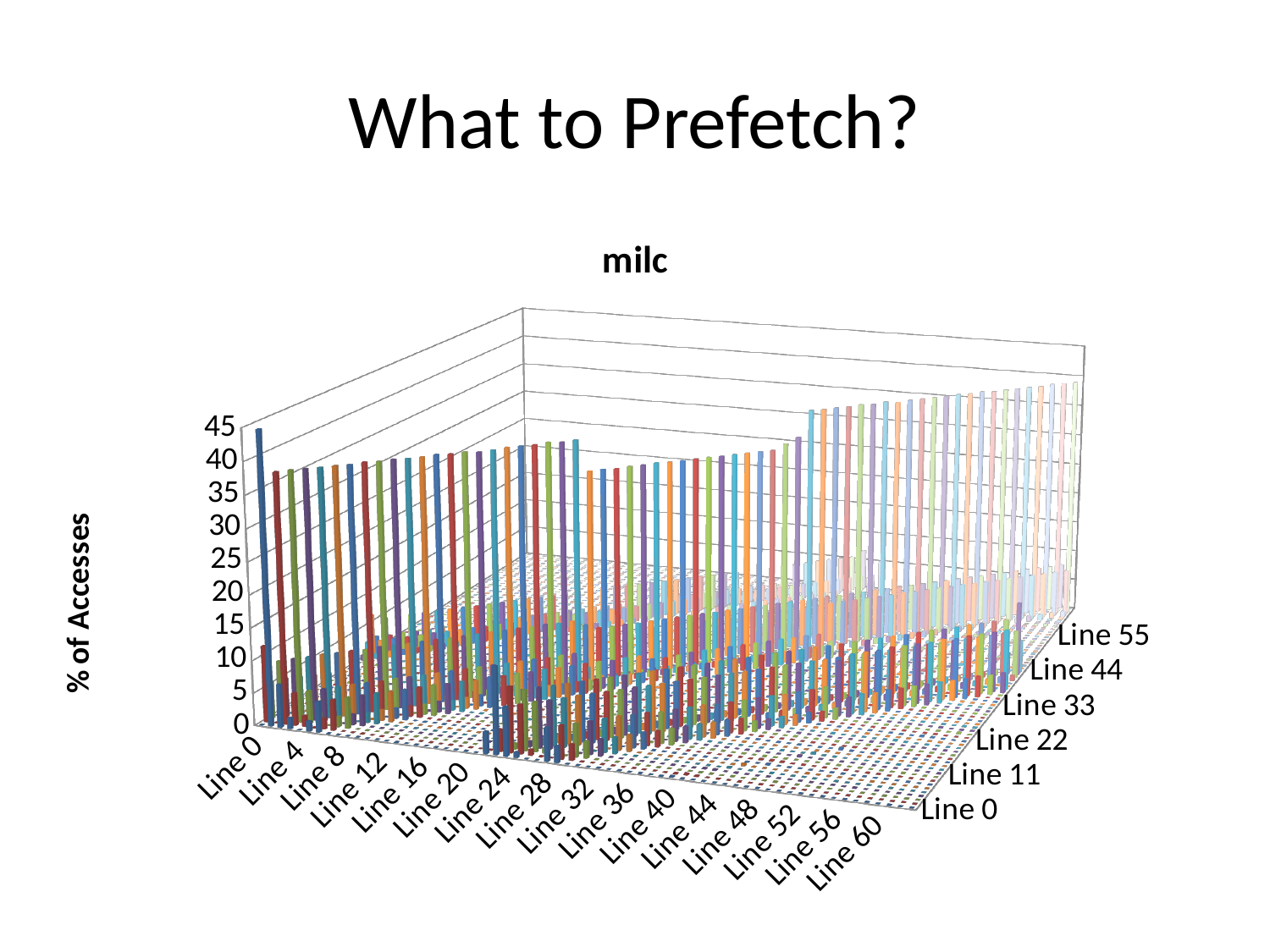
What kind of chart is shown on the slide? 3D bar chart What is the label on the vertical axis of the chart? % of Accesses What is the last category label on the front horizontal axis? Line 60 What is the highest tick value shown on the vertical axis? 45 Is the value of the tallest bar at Line 0 in the front row greater or less than 30? greater How many category labels are printed along the front horizontal axis (Line 0 through Line 60)? 16 What is the lowest tick value shown on the vertical axis? 0 What is the last label on the depth axis? Line 55 What is the title of the chart? milc What is the interval between consecutive tick marks on the vertical axis? 5 How many labels are printed along the depth axis (Line 0 through Line 55)? 6